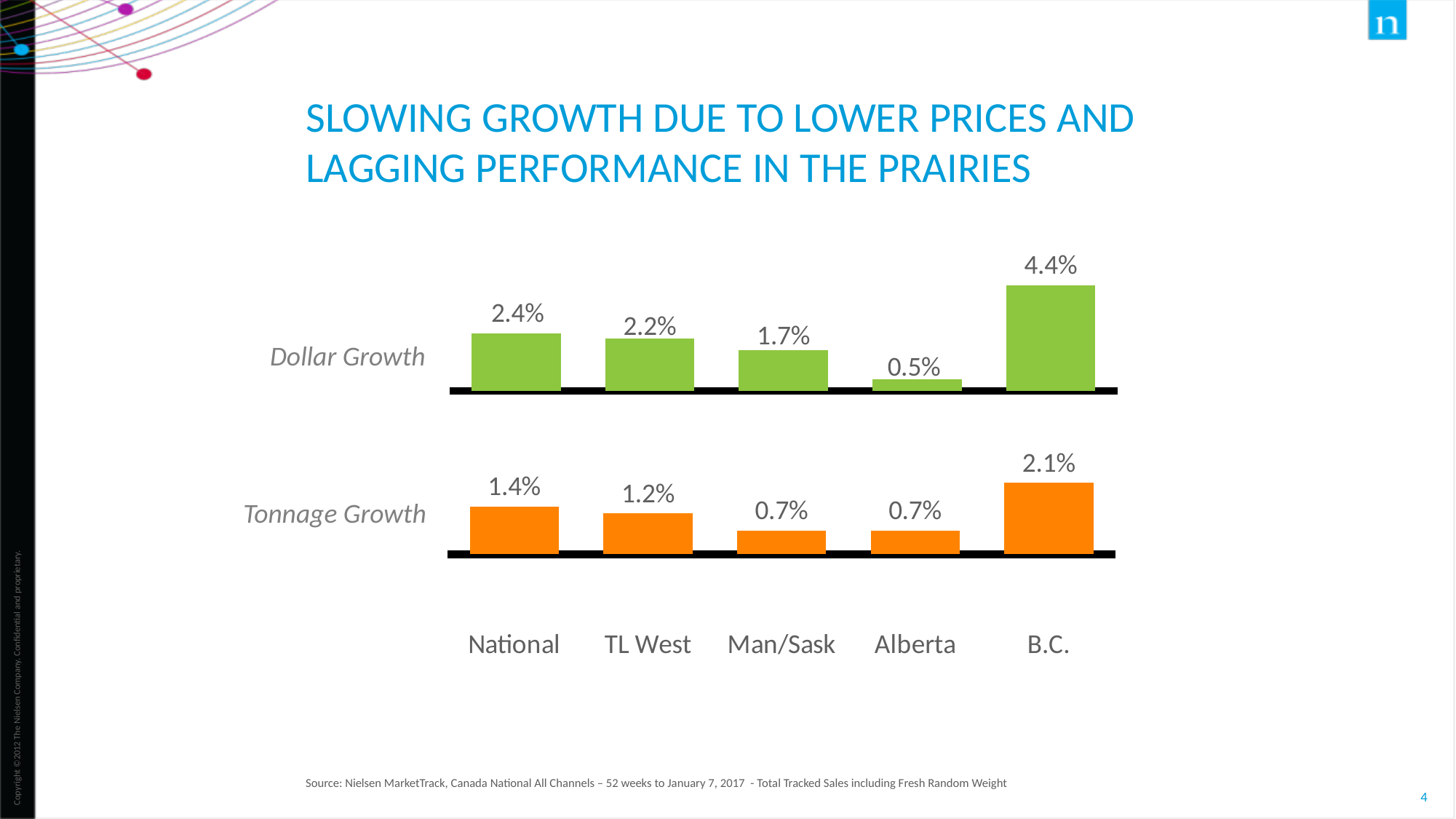
In the Dollar Growth chart, what is the value for Alberta? 0.5% In the Dollar Growth chart, which region has the highest value? B.C. In the Tonnage Growth chart, which region has the highest value? B.C. In the Tonnage Growth chart, what is the value for TL West? 1.2% In the Tonnage Growth chart, what is the value for National? 1.4% How many regions are shown in the Tonnage Growth chart? 5 In the Dollar Growth chart, which is larger, TL West or Man/Sask? TL West What type of chart is the Dollar Growth chart? Bar chart In the Dollar Growth chart, what is the difference between B.C. and National? 2.0% In the Dollar Growth chart, what is the value for B.C.? 4.4% In the Tonnage Growth chart, what is the difference between National and Man/Sask? 0.7% In the Dollar Growth chart, which region has the lowest value? Alberta